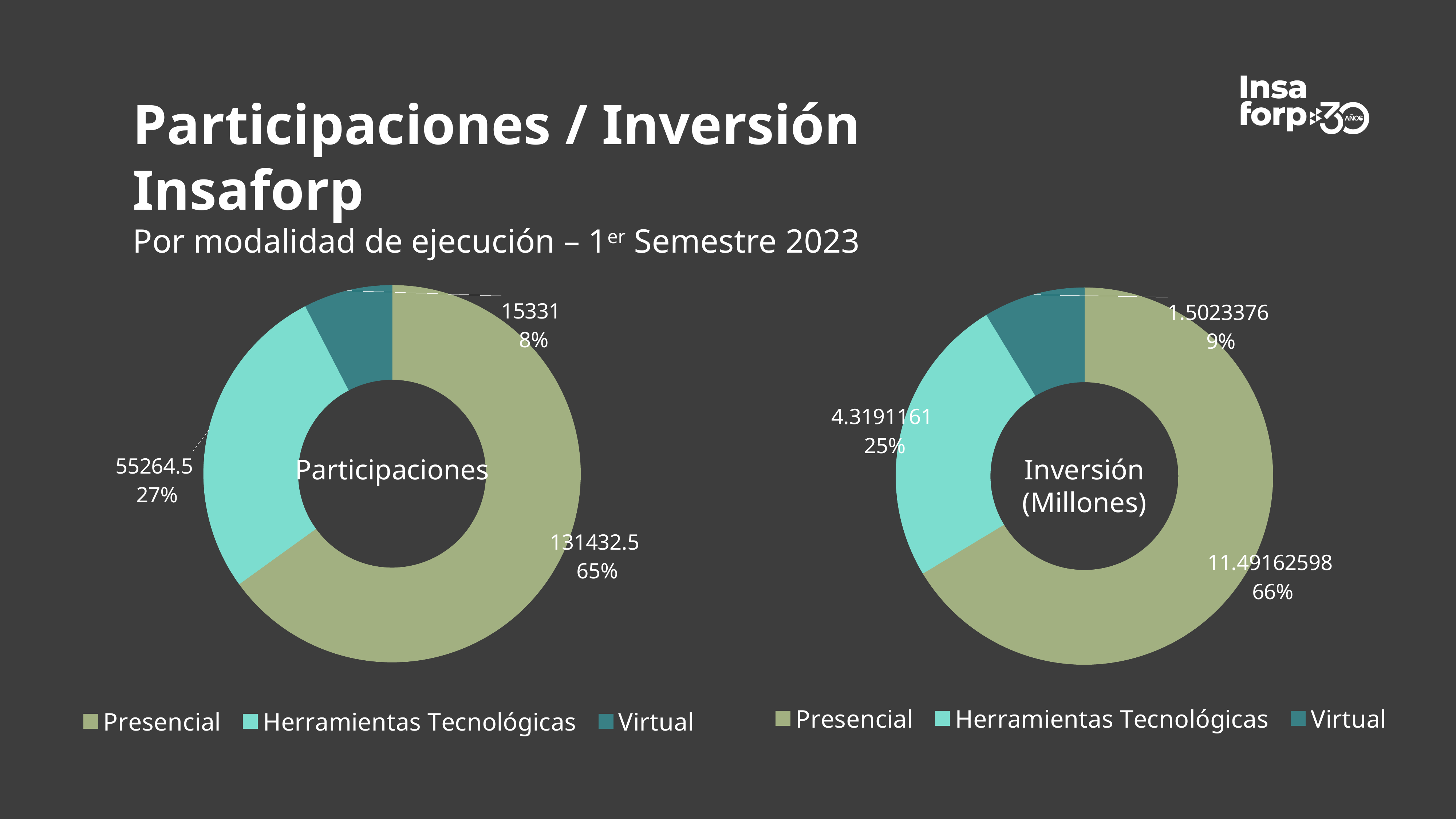
How many categories does the Inversión (Millones) chart show? 3 In the Participaciones chart, which is larger, Herramientas Tecnológicas or Virtual? Herramientas Tecnológicas In the Inversión (Millones) chart, what is the value for Presencial? 11.49162598 In the Participaciones chart, which category has the smallest slice? Virtual In the Participaciones chart, what is the value for Presencial? 131432.5 In the Participaciones chart, what is the value for Virtual? 15331 In the Inversión (Millones) chart, which category has the largest slice? Presencial In the Participaciones chart, what share does Herramientas Tecnológicas have? 27% What type of chart is the Participaciones chart? Doughnut chart In the Inversión (Millones) chart, what is the value for Herramientas Tecnológicas? 4.3191161 In the Inversión (Millones) chart, what share does Virtual have? 9% In the Participaciones chart, what is the difference between the Presencial and Herramientas Tecnológicas values? 76168